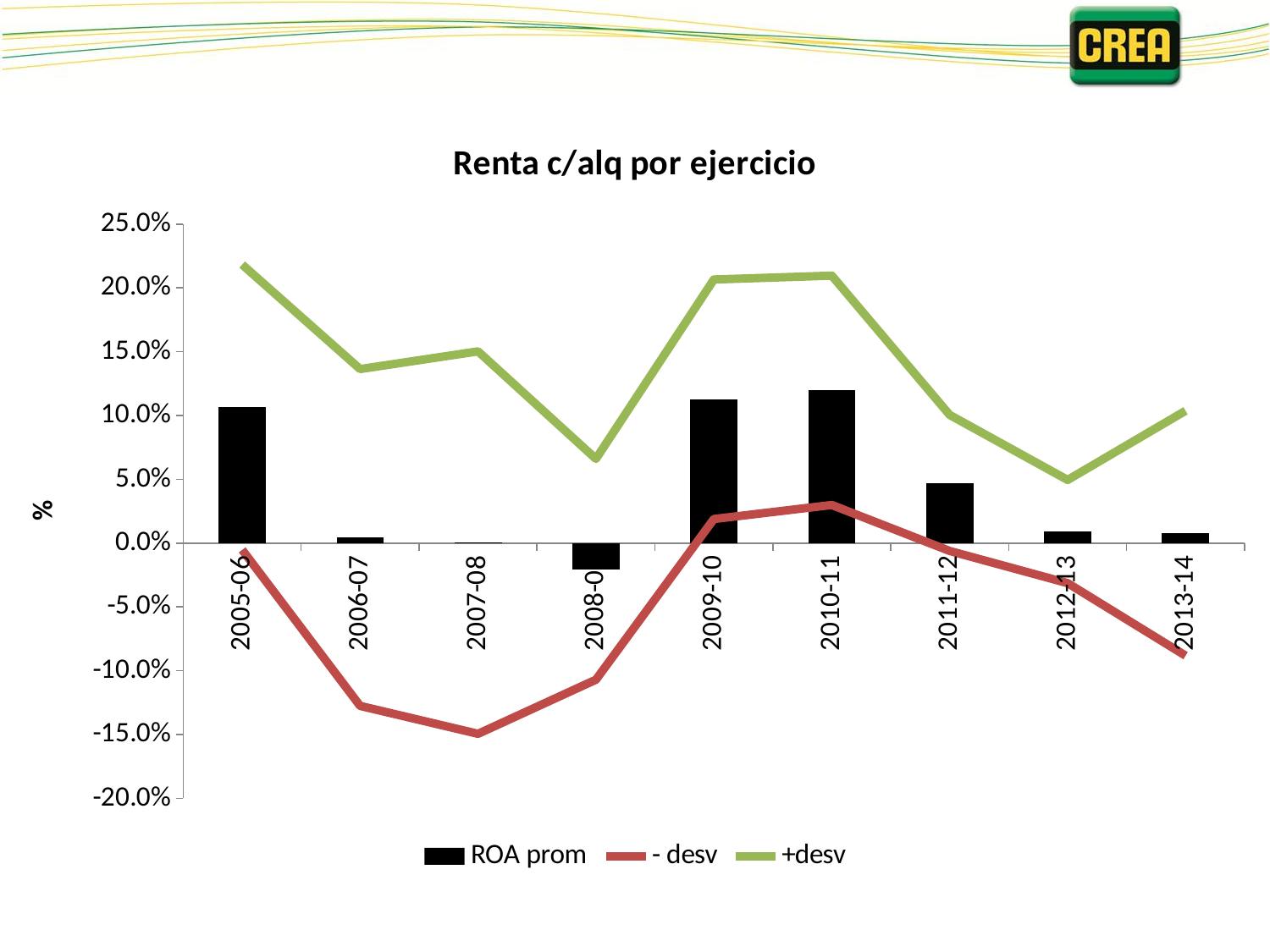
Which is larger, the +desv value for 2009-10 or for 2006-07? 2009-10 Does the +desv line rise or fall from 2010-11 to 2012-13? fall In which period is the - desv line at its lowest? 2007-08 Which series is drawn as a red line? - desv What kind of chart is shown on the slide? A combined bar and line chart Is the - desv value for 2007-08 greater or less than -10.0%? less How many ejercicios (periods) are shown on the x axis? 9 How many series does the legend list? 3 Is the +desv value for 2005-06 greater or less than 20.0%? greater Is the +desv value for 2012-13 greater or less than 10.0%? less What is the title of the chart? Renta c/alq por ejercicio